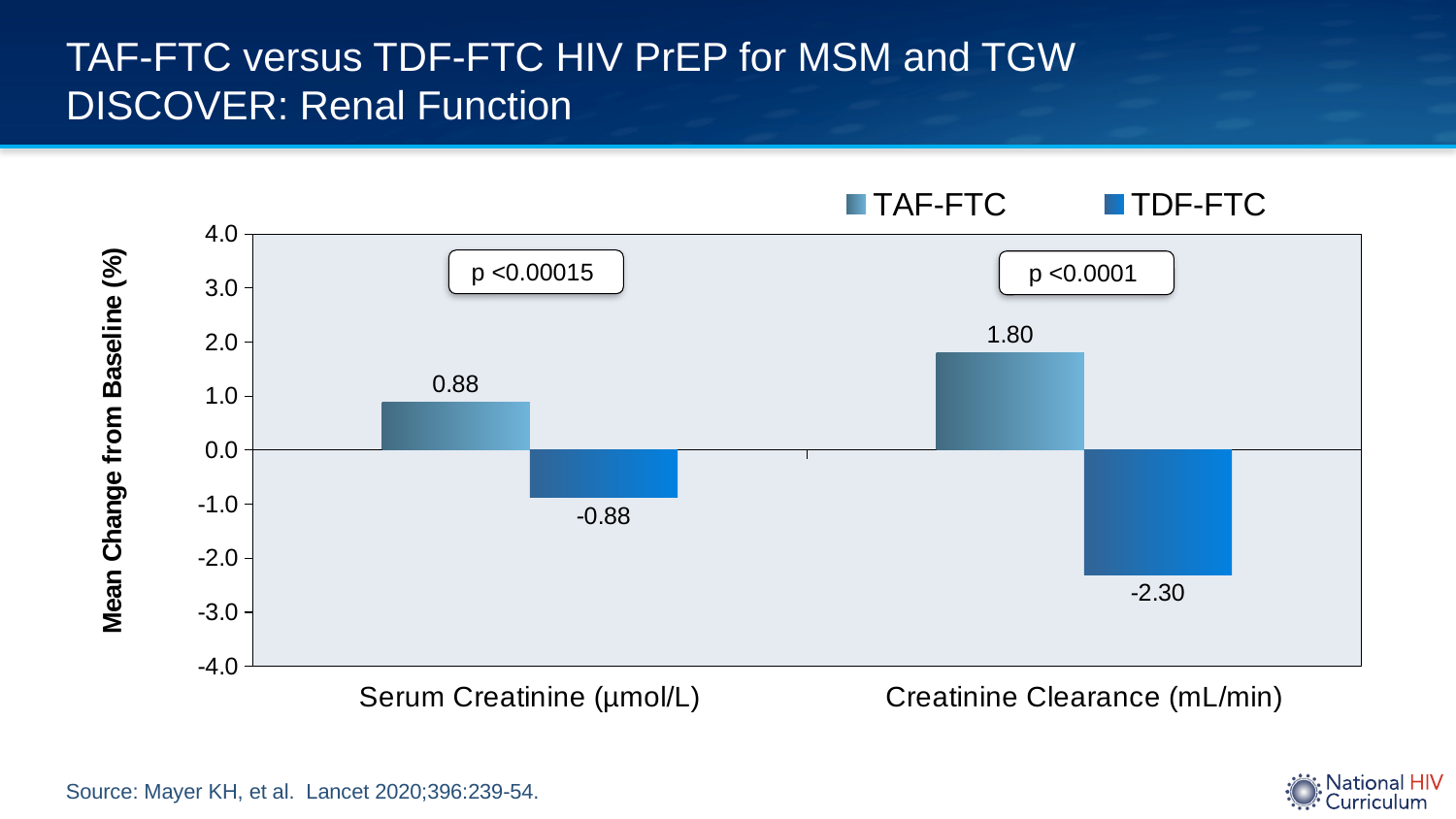
What kind of chart is shown on the slide? Bar chart What is the difference between the TAF-FTC and TDF-FTC values for Serum Creatinine (µmol/L)? 1.76 How many series does the legend list? 2 What is the mean change from baseline for TAF-FTC in Serum Creatinine (µmol/L)? 0.88 What is the mean change from baseline for TDF-FTC in Creatinine Clearance (mL/min)? -2.30 What is the mean change from baseline for TDF-FTC in Serum Creatinine (µmol/L)? -0.88 Which series has the higher value for Creatinine Clearance (mL/min), TAF-FTC or TDF-FTC? TAF-FTC What is the difference between the TAF-FTC and TDF-FTC values for Creatinine Clearance (mL/min)? 4.10 What is the y-axis label of the chart? Mean Change from Baseline (%) Which bar shows the lowest value on the chart? TDF-FTC, Creatinine Clearance (mL/min) Which bar shows the highest value on the chart? TAF-FTC, Creatinine Clearance (mL/min) What is the mean change from baseline for TAF-FTC in Creatinine Clearance (mL/min)? 1.80